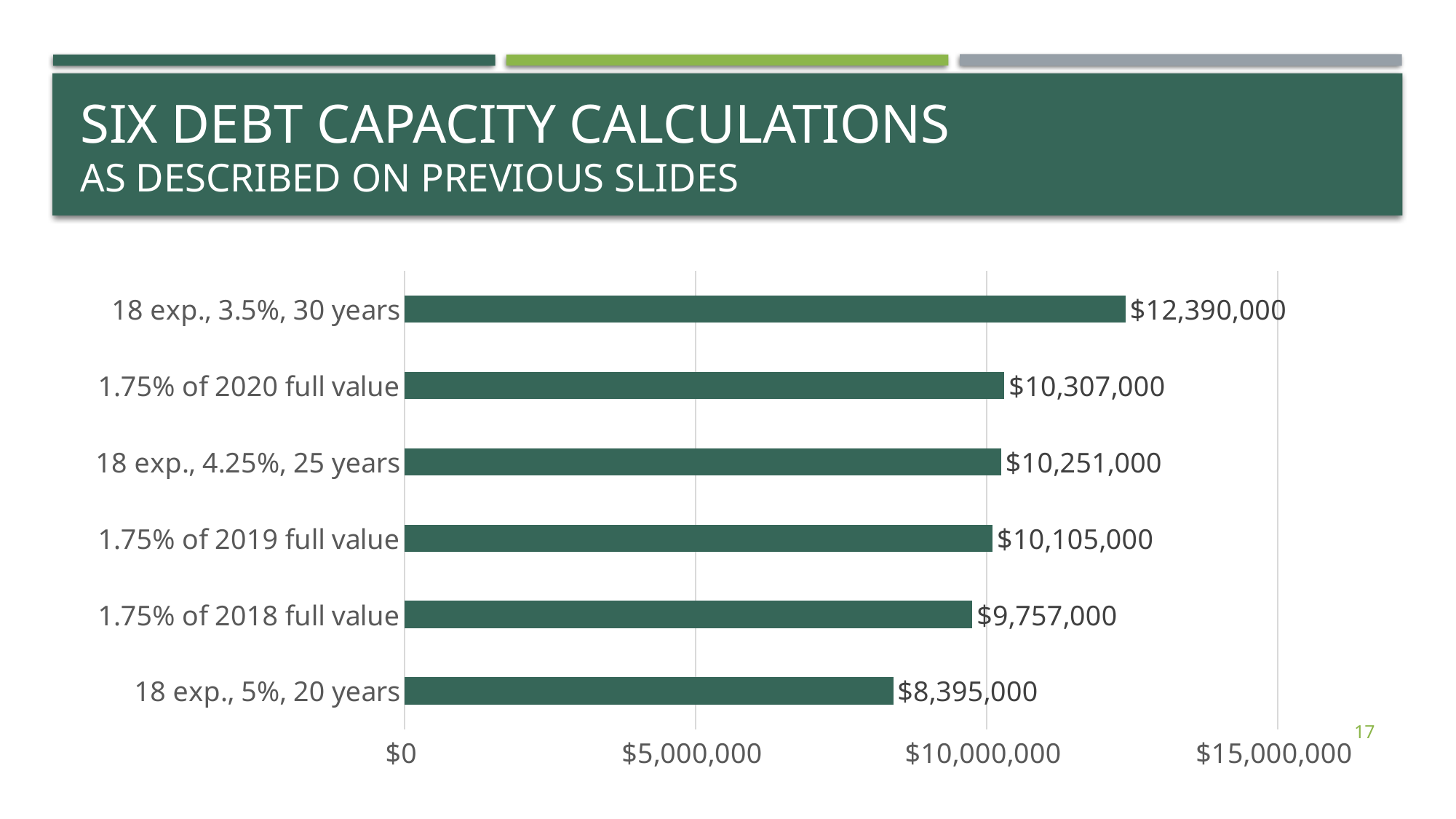
How many categories are shown in the chart? 6 Which category has the lowest value? 18 exp., 5%, 20 years Which category has the highest value? 18 exp., 3.5%, 30 years Which is larger, the value for "1.75% of 2020 full value" or the value for "18 exp., 4.25%, 25 years"? 1.75% of 2020 full value What is the difference between the values for "18 exp., 3.5%, 30 years" and "18 exp., 5%, 20 years"? $3,995,000 Is the value for "1.75% of 2018 full value" greater or less than $10,000,000? less What is the title of the slide? Six Debt Capacity Calculations What is the value for "1.75% of 2018 full value"? $9,757,000 What is the value for "18 exp., 5%, 20 years"? $8,395,000 What is the value for "18 exp., 3.5%, 30 years"? $12,390,000 What kind of chart is shown on the slide? bar chart What is the difference between the values for "1.75% of 2020 full value" and "1.75% of 2019 full value"? $202,000